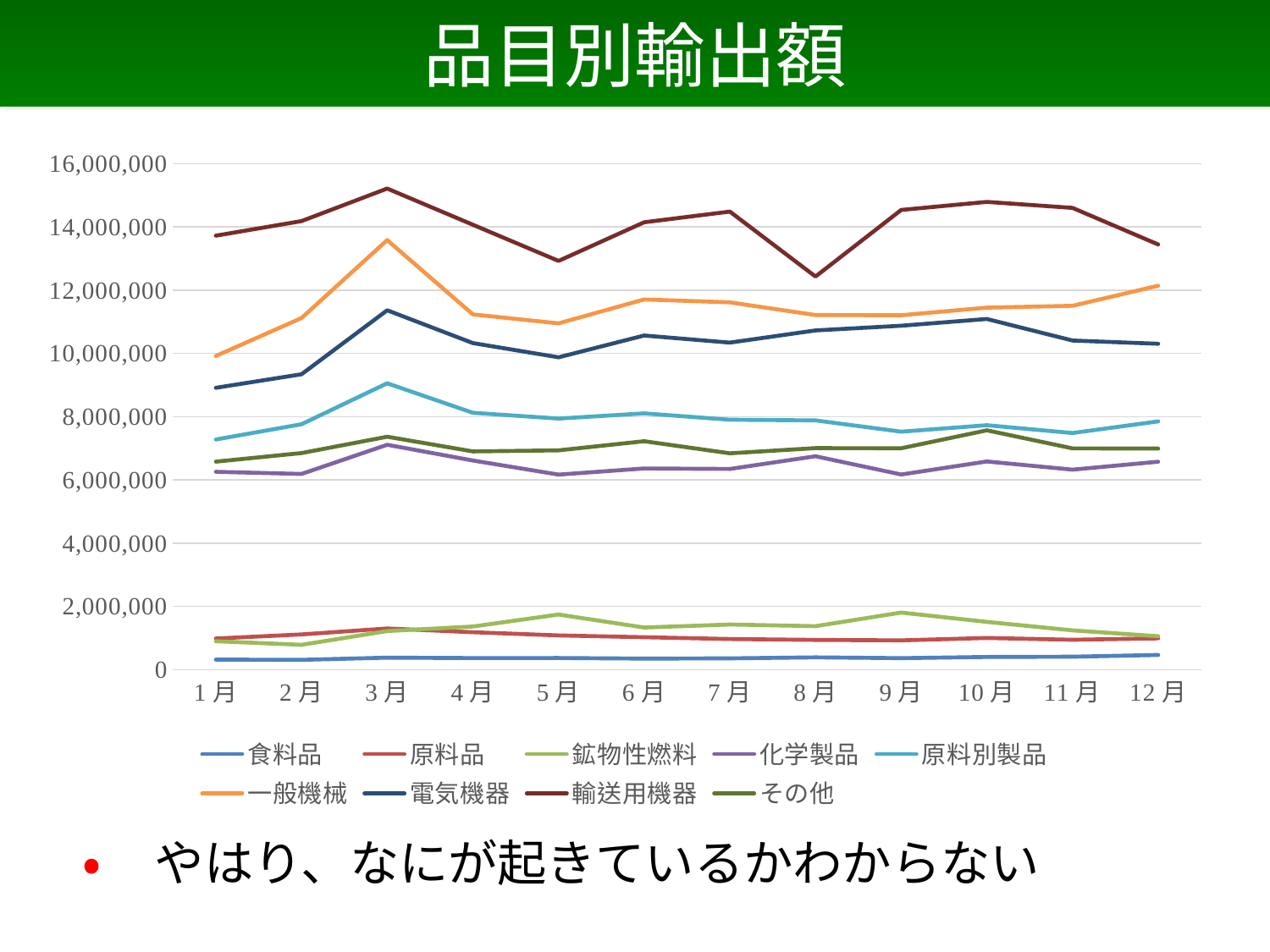
Which series has the highest values across the year? 輸送用機器 Is the value for 輸送用機器 in 3月 greater or less than 14,000,000? greater Is the value for 一般機械 in 3月 greater or less than 12,000,000? greater In 1月, which is larger: 一般機械 or 電気機器? 一般機械 In 9月, which is larger: 鉱物性燃料 or 原料品? 鉱物性燃料 What is the title of the chart? 品目別輸出額 How many months are plotted along the x axis? 12 Is the value for 輸送用機器 in 8月 greater or less than 14,000,000? less Which series has the lowest values across the year? 食料品 What kind of chart is shown on the slide? line chart How many series does the legend list? 9